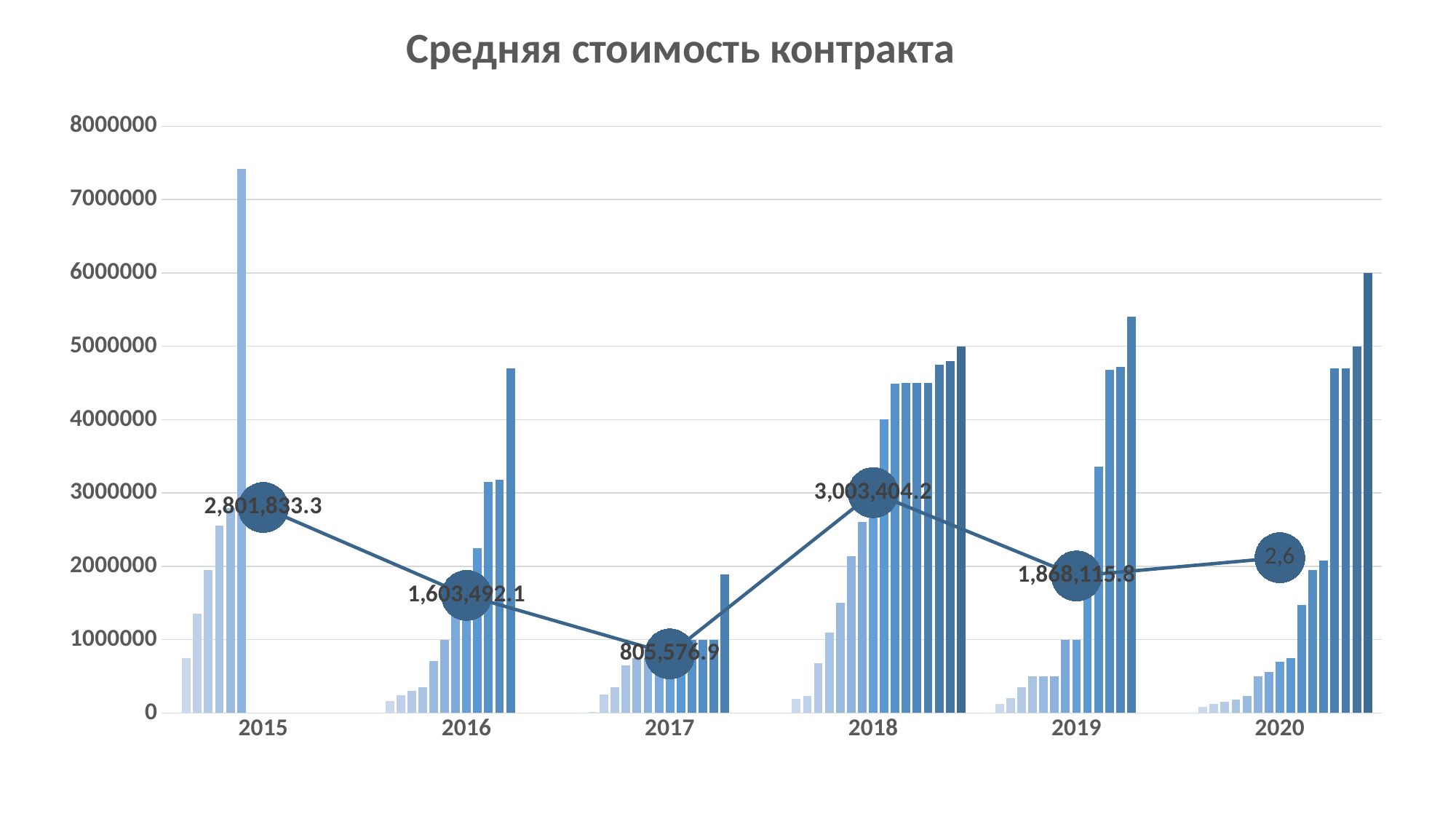
Which is larger, the labelled line value for 2015 or for 2019? 2015 What is the labelled value of the line for 2019? 1,868,115.8 What is the labelled value of the line for 2015? 2,801,833.3 What is the labelled value of the line for 2016? 1,603,492.1 What is the labelled value of the line for 2018? 3,003,404.2 Is the tallest bar in the 2015 group greater or less than 7000000? greater What is the title of the chart? Средняя стоимость контракта Which year has the highest labelled line value? 2018 Which year has the lowest labelled line value? 2017 How many years are shown on the x axis? 6 What is the difference between the labelled line values for 2018 and 2017? 2,197,827.3 What is the labelled value of the line for 2017? 805,576.9